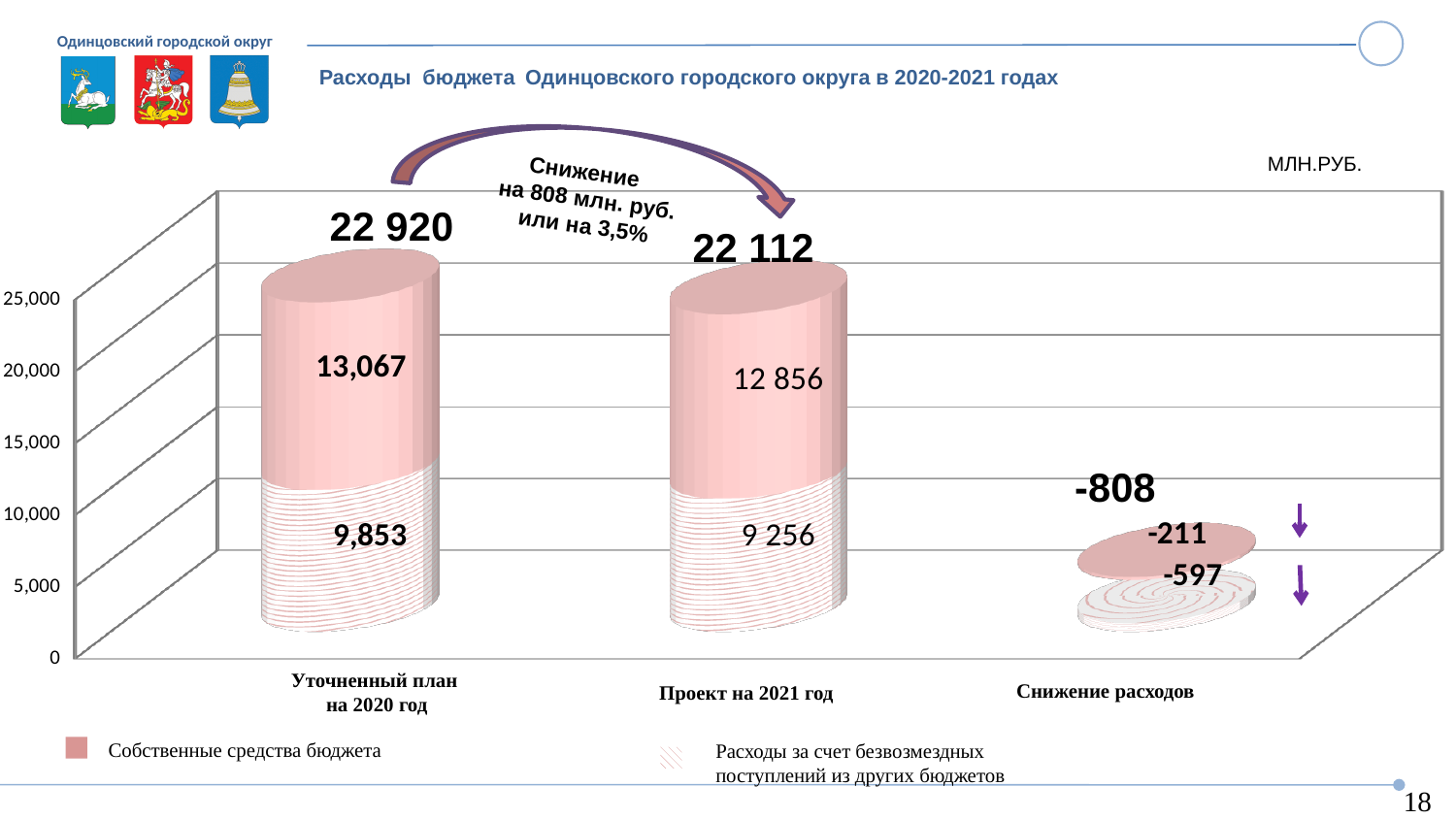
What is the total expenditure shown for 'Уточненный план на 2020 год'? 22 920 Which is larger: 'Собственные средства бюджета' for 2020 (13,067) or for 2021 (12 856)? 2020 (13,067) Which category has the highest total expenditure? Уточненный план на 2020 год What is the value of 'Расходы за счет безвозмездных поступлений из других бюджетов' in the 'Снижение расходов' category? -597 What unit of measurement is indicated for the chart values? МЛН.РУБ. What is the total shown for the 'Снижение расходов' category? -808 What is the value of 'Собственные средства бюджета' in the 'Снижение расходов' category? -211 What is the total expenditure shown for 'Проект на 2021 год'? 22 112 What is the value of 'Собственные средства бюджета' for 'Уточненный план на 2020 год'? 13,067 What type of chart is shown on the slide? Stacked bar chart What is the value of 'Расходы за счет безвозмездных поступлений из других бюджетов' for 'Проект на 2021 год'? 9 256 How many series does the legend list? 2